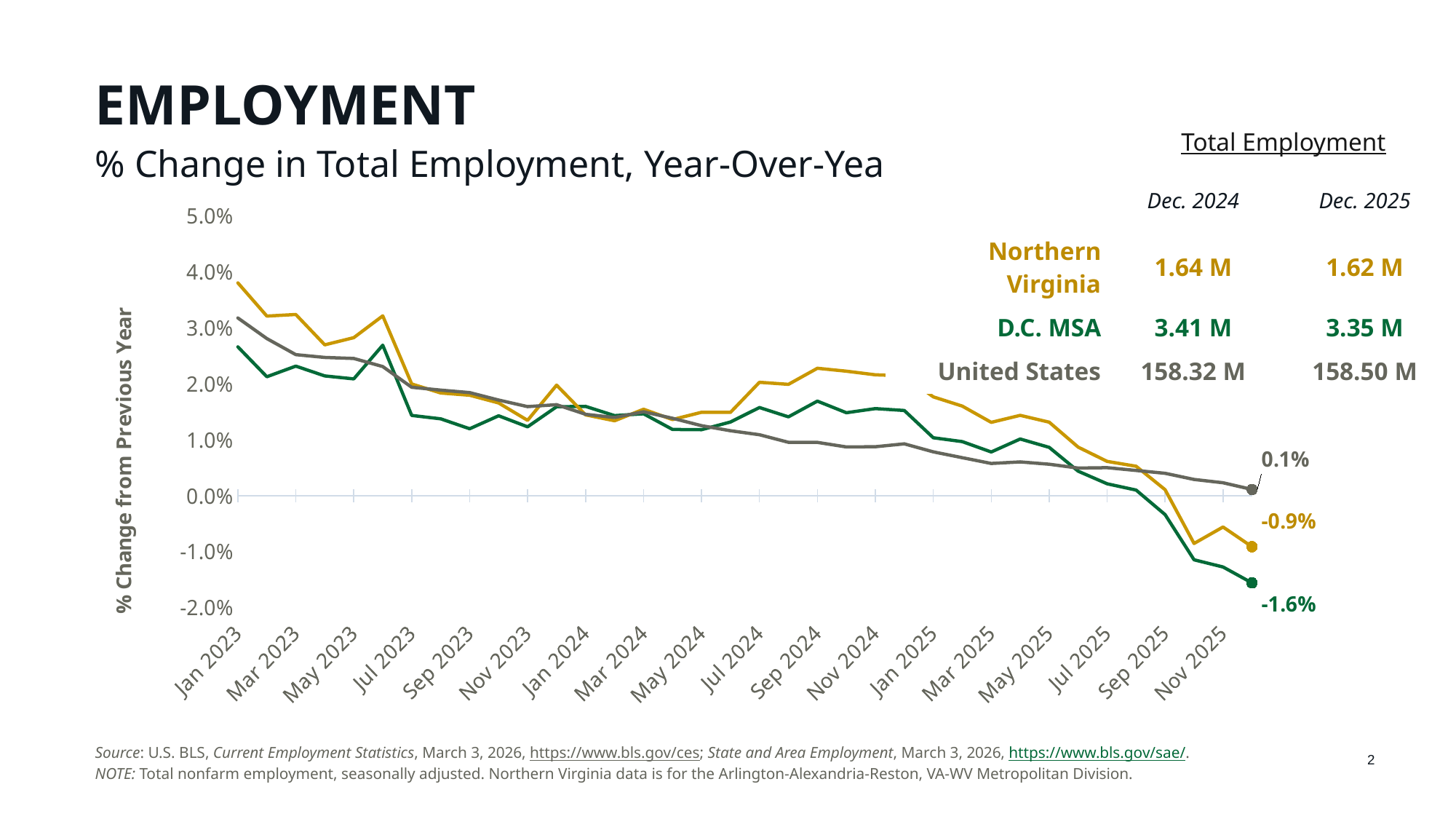
At the last point on the chart, what is the difference between the United States value (0.1%) and the D.C. MSA value (-1.6%)? 1.7% Is the Northern Virginia value in Jan 2023 greater or less than 3.0%? greater What is the year-over-year % change in total employment for the United States at the last point on the chart (Nov 2025)? 0.1% What kind of chart is shown on the slide? line chart How many series (lines) are plotted on the chart? 3 Do the lines generally rise or fall from Jan 2023 to Nov 2025? fall What is the year-over-year % change in total employment for Northern Virginia at the last point on the chart? -0.9% Which series has the highest value at the last point on the chart? United States What is the year-over-year % change in total employment for the D.C. MSA at the last point on the chart? -1.6% Which series has the lowest value at the last point on the chart? D.C. MSA What is the title of the vertical axis? % Change from Previous Year At the last point on the chart, what is the difference between the Northern Virginia value (-0.9%) and the D.C. MSA value (-1.6%)? 0.7%